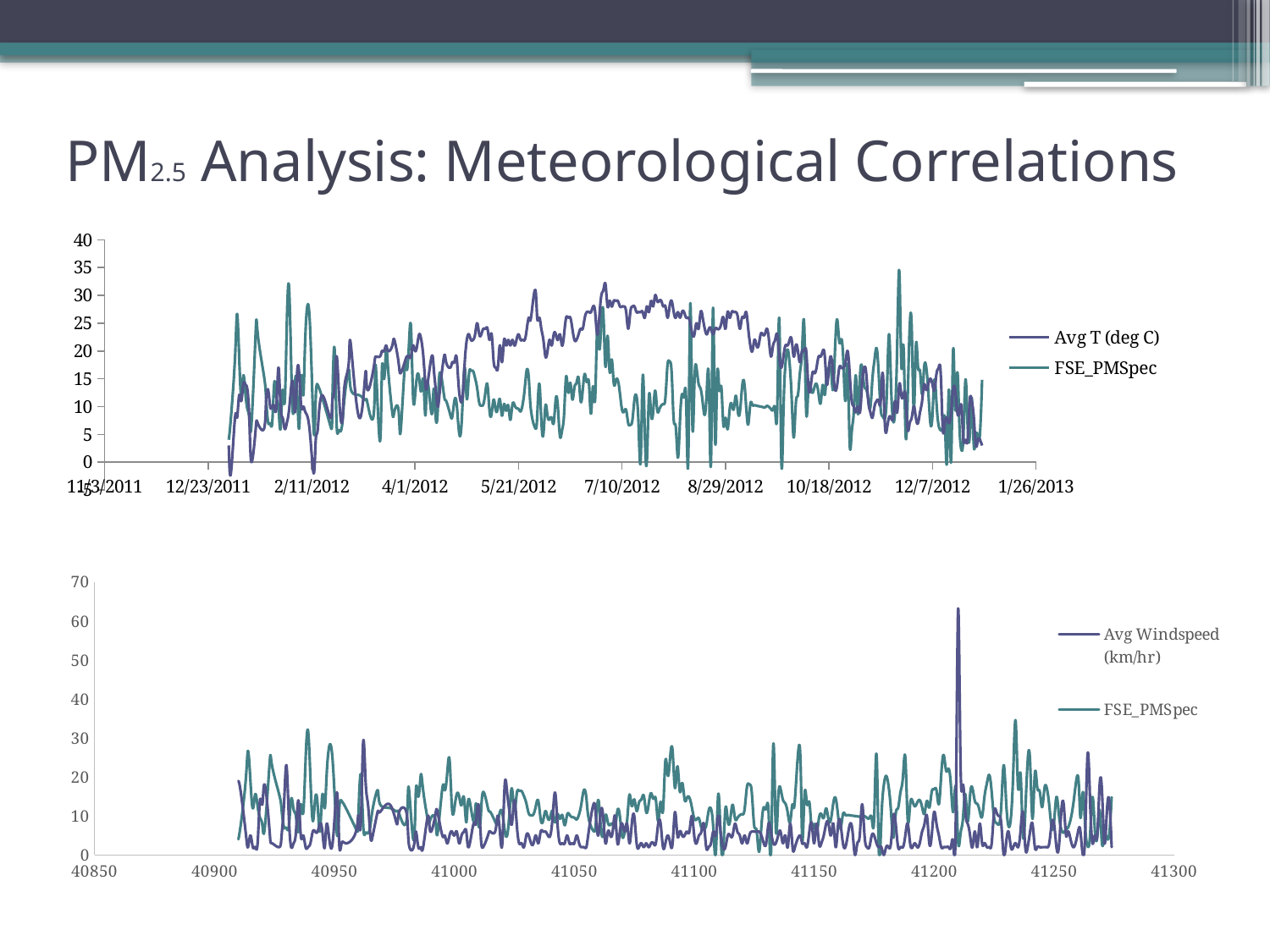
In the top chart, does the Avg T (deg C) series generally rise or fall between 2/11/2012 and 7/10/2012? rise In the top chart, is the Avg T (deg C) value around 7/10/2012 greater or less than 20? greater How many series does the legend of the top chart list? 2 In the bottom chart, which series reaches the higher single peak value, Avg Windspeed (km/hr) or FSE_PMSpec? Avg Windspeed (km/hr) How many series does the legend of the bottom chart list? 2 In the bottom chart, which series is plotted alongside FSE_PMSpec? Avg Windspeed (km/hr) In the bottom chart, is the highest peak of the Avg Windspeed (km/hr) series greater or less than 50? greater In the bottom chart, is the highest peak of the FSE_PMSpec series greater or less than 40? less In the top chart, which series is plotted alongside FSE_PMSpec? Avg T (deg C) What kind of chart is the bottom chart on the slide? line chart What kind of chart is the top chart on the slide? line chart